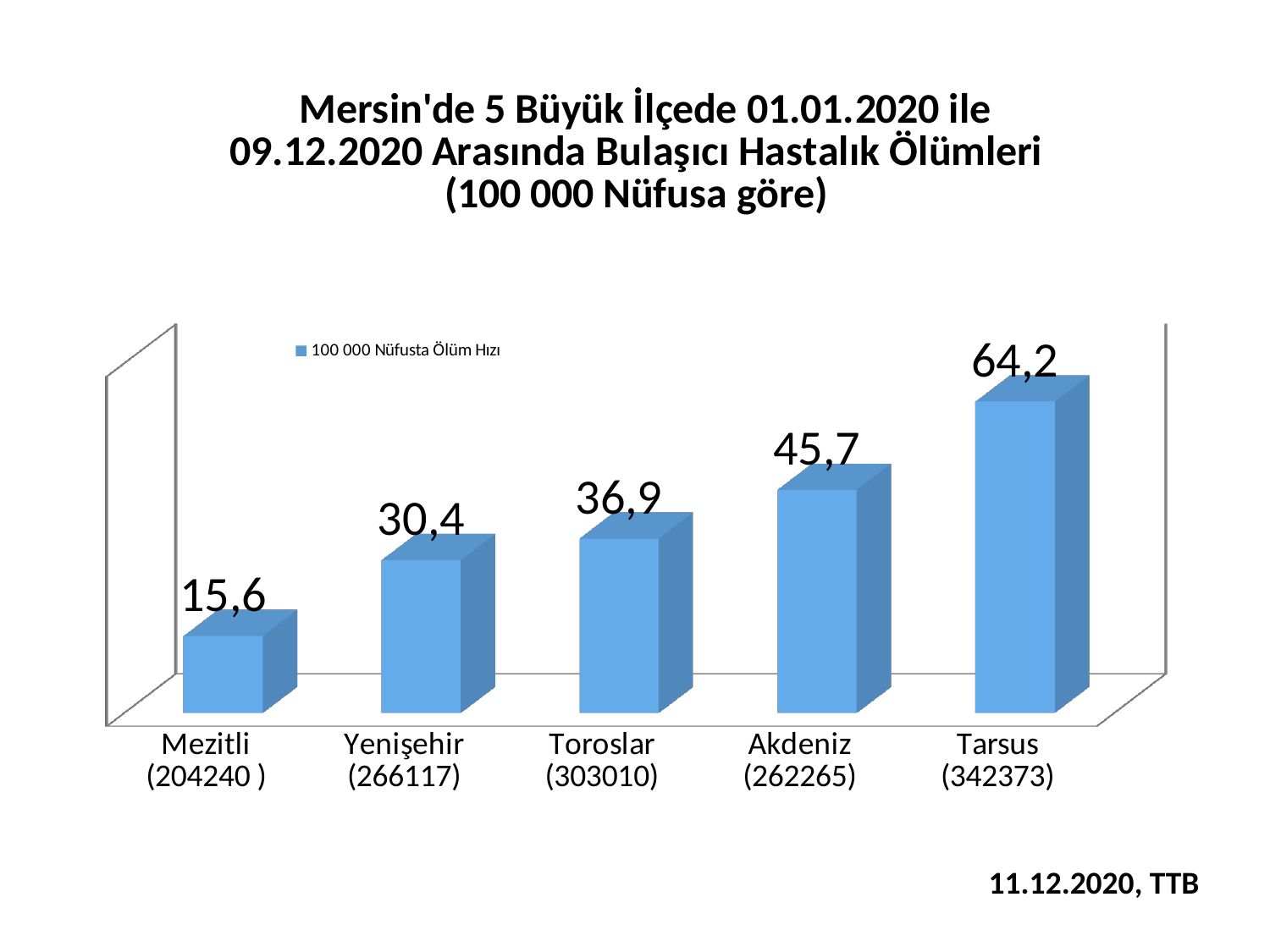
What is the value for Tarsus? 64,2 What is the difference between the values for Akdeniz and Yenişehir? 15,3 What kind of chart is shown on the slide? Bar chart How many series does the legend list? 1 What is the value for Toroslar? 36,9 What is the value for Mezitli? 15,6 Do the values rise or fall from Mezitli to Tarsus along the x axis? Rise Which district has the lowest death rate per 100 000 population? Mezitli Which is larger, the value for Akdeniz or the value for Toroslar? Akdeniz What is the difference between the values for Tarsus and Mezitli? 48,6 How many districts are shown in the chart? 5 Which district has the highest death rate per 100 000 population? Tarsus